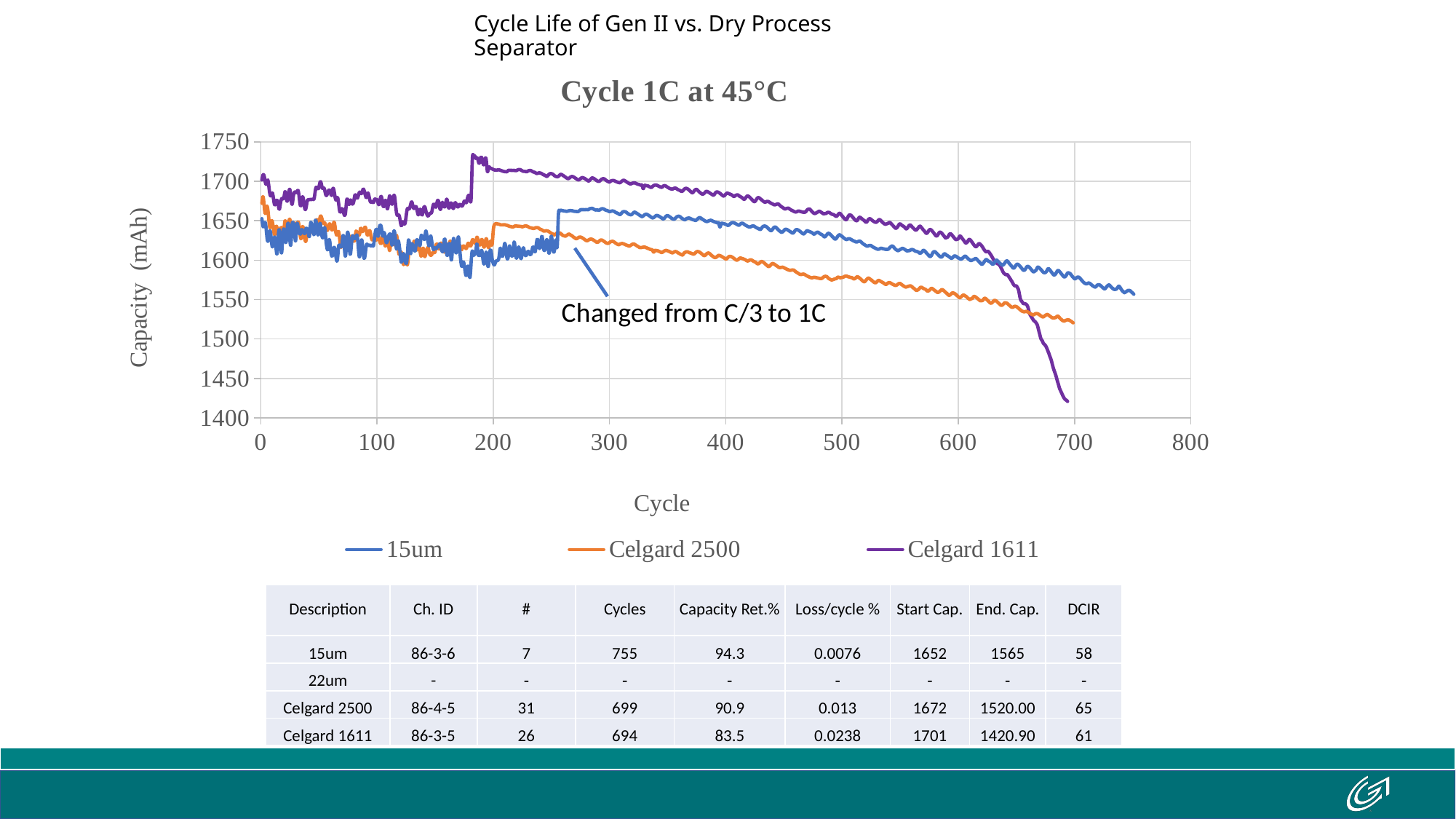
Is the capacity for Celgard 1611 at cycle 400 greater or less than 1650? greater Is the capacity for Celgard 2500 at cycle 500 greater or less than 1600? less What kind of chart is shown on the slide? line chart Which series has the lowest capacity at cycle 690? Celgard 1611 Is the final capacity value for Celgard 1611 greater or less than 1450? less Which series has the lowest capacity at cycle 600? Celgard 2500 At cycle 500, which series has the larger capacity, 15um or Celgard 2500? 15um What does the annotation on the chart say? Changed from C/3 to 1C How many series does the chart legend list? 3 What is the title of the chart? Cycle 1C at 45°C Which series has the highest capacity at cycle 400? Celgard 1611 Does the capacity for Celgard 1611 rise or fall between cycle 200 and cycle 690? fall